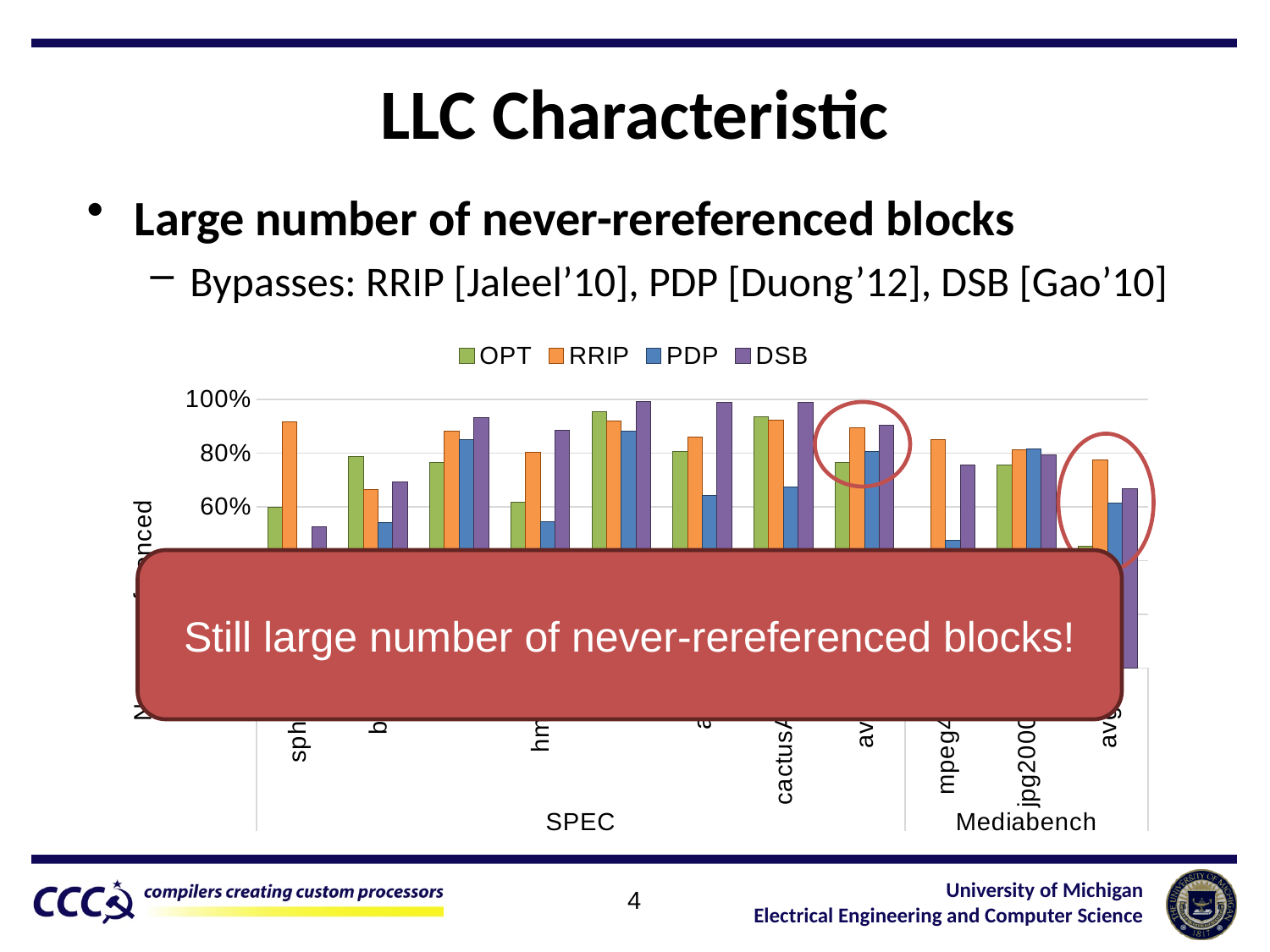
For PDP, which is larger: the value for mpeg4 or the value for jpg2000? jpg2000 Is the RRIP value for mpeg4 greater or less than 80%? greater Is the PDP value for mpeg4 greater or less than 60%? less Is the OPT value for jpg2000 greater or less than 80%? less What are the two benchmark groups labelled along the bottom of the chart? SPEC and Mediabench What are the series names listed in the chart legend? OPT, RRIP, PDP, DSB What kind of chart is shown on the slide? bar chart How many series does the chart legend list? 4 Which series has the lowest value for jpg2000? OPT Which series has the highest value for mpeg4? RRIP